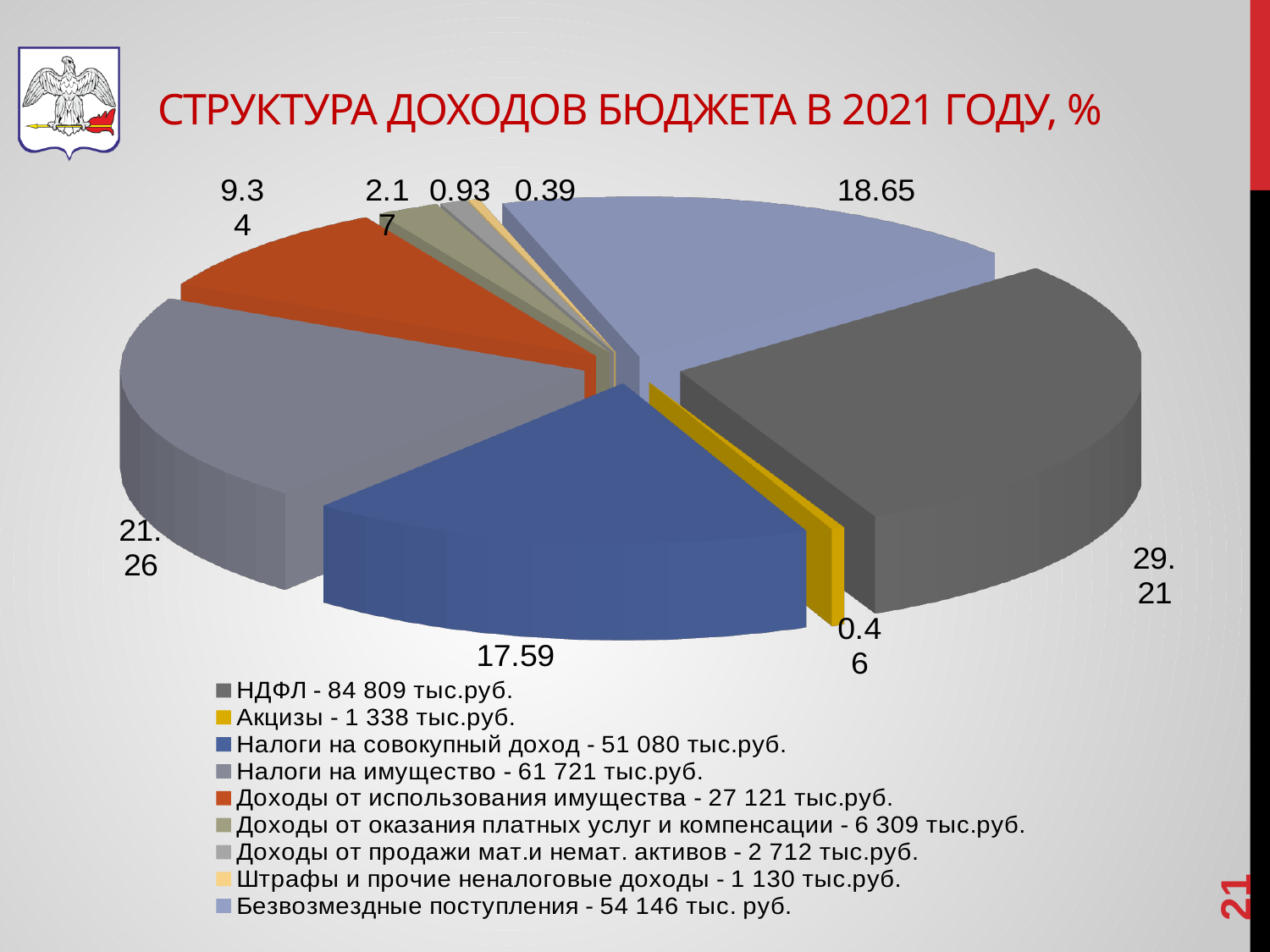
What is the value shown for the Безвозмездные поступления slice? 18.65 How many slices does the pie chart have? 9 What is the value shown for the НДФЛ slice? 29.21 Which category has the smallest slice of the pie? Штрафы и прочие неналоговые доходы - 1 130 тыс.руб. Which is larger, the value for Доходы от использования имущества or the value for Доходы от оказания платных услуг и компенсации? Доходы от использования имущества How many entries does the legend list? 9 What is the value shown for the Налоги на совокупный доход slice? 17.59 What is the value shown for the Акцизы slice? 0.46 What kind of chart is shown on the slide? pie chart Which category has the largest slice of the pie? НДФЛ - 84 809 тыс.руб. What is the difference between the values for Налоги на имущество and Налоги на совокупный доход? 3.67 What is the title of the chart? СТРУКТУРА ДОХОДОВ БЮДЖЕТА В 2021 ГОДУ, %